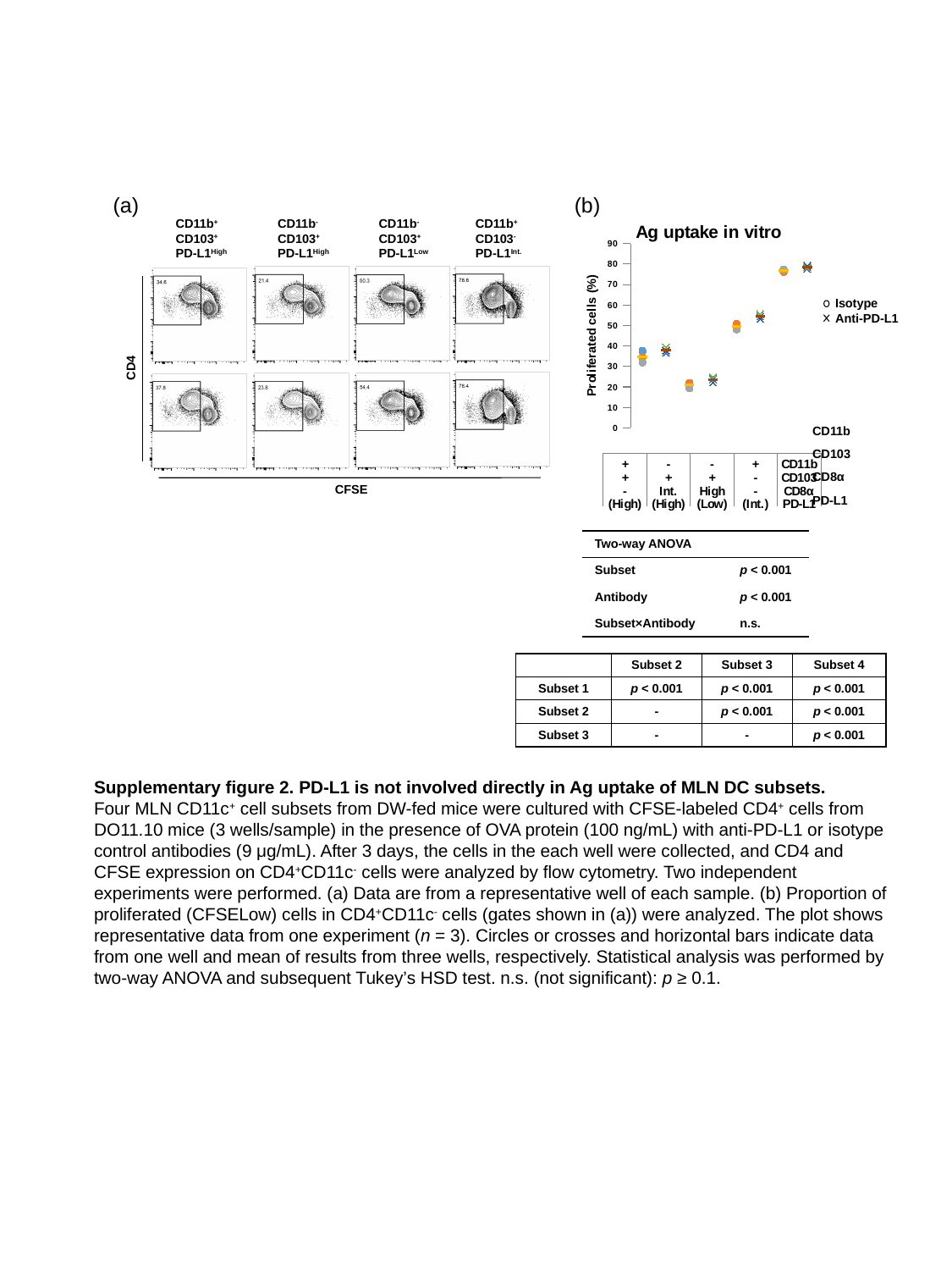
How many DC subset groups are plotted along the x-axis of the 'Ag uptake in vitro' chart? 4 In the 'Ag uptake in vitro' chart, are the values for the CD11b+ CD103+ PD-L1 (High) group greater or less than 50? less In the 'Ag uptake in vitro' chart, are the values for the CD11b- CD103+ PD-L1 High (Low) group greater or less than 40? greater What kind of chart is 'Ag uptake in vitro'? scatter chart In the 'Ag uptake in vitro' chart, which subset group has the highest proliferated cells (%)? CD11b+ CD103- PD-L1 (Int.) In the 'Ag uptake in vitro' chart, which group has higher proliferated cells (%): CD11b- CD103+ PD-L1 High (Low) or CD11b+ CD103+ PD-L1 (High)? CD11b- CD103+ PD-L1 High (Low) In the 'Ag uptake in vitro' chart, are the values for the CD11b+ CD103- PD-L1 (Int.) group greater or less than 70? greater In the 'Ag uptake in vitro' chart, which subset group has the lowest proliferated cells (%)? CD11b- CD103+ PD-L1 Int. (High) What is the title of the chart in panel (b)? Ag uptake in vitro In the 'Ag uptake in vitro' chart, what is the label on the y-axis? Proliferated cells (%) How many series does the legend of the 'Ag uptake in vitro' chart list? 2